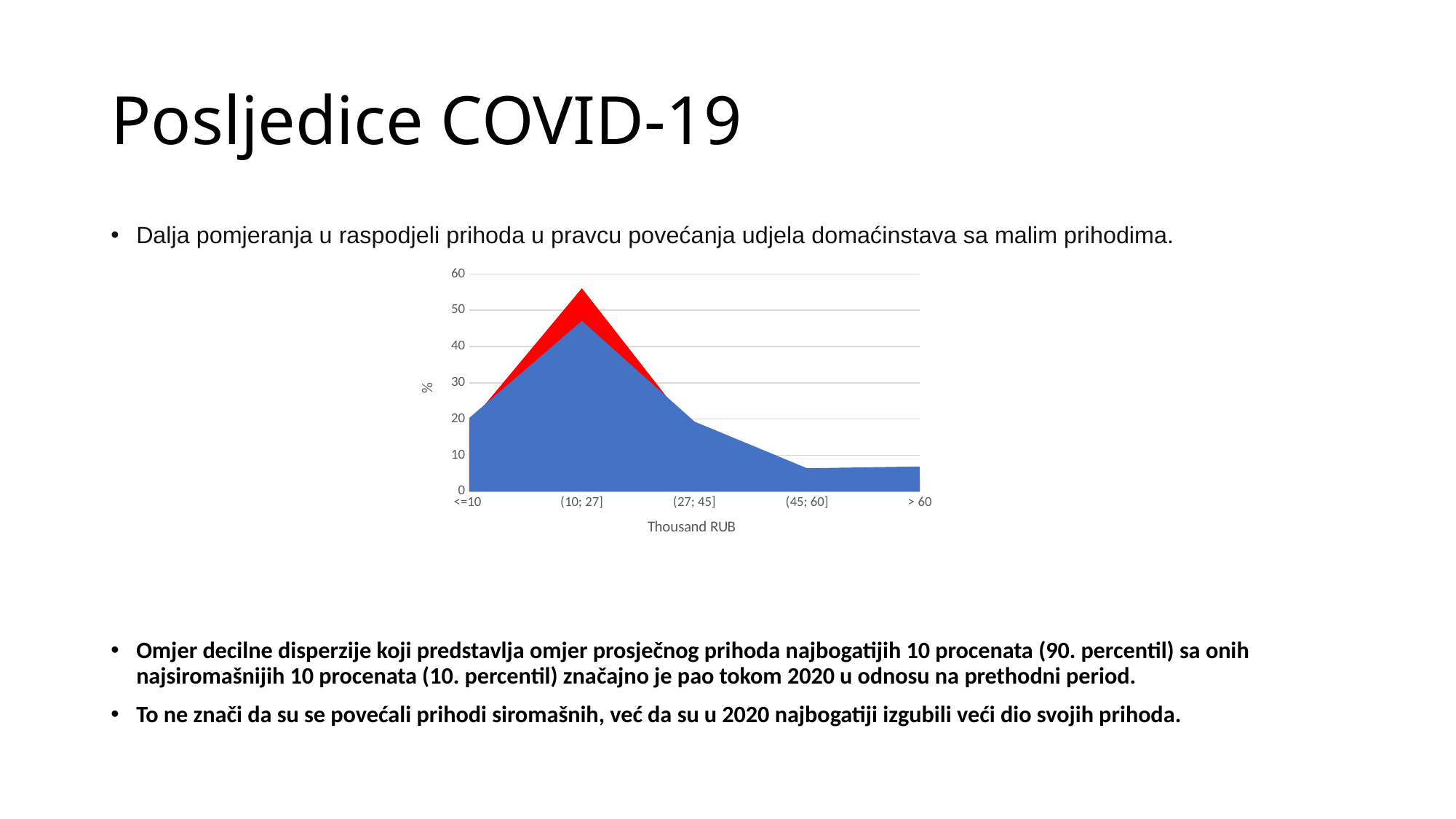
What kind of chart is shown on the slide? area chart Is the value for (45; 60] greater or less than 10? less Which income category has the highest value for the blue area? (10; 27] Do the values rise or fall along the x axis from (10; 27] to (45; 60]? fall Which is larger for the blue area: the value for (10; 27] or the value for (27; 45]? (10; 27] Which income category has the highest value for the red area? (10; 27] What is the label of the x axis of the chart? Thousand RUB Is the peak of the red area at (10; 27] greater or less than 50? greater Is the value of the blue area for (10; 27] greater or less than 40? greater What is the label of the y axis of the chart? % How many income categories are shown on the x axis of the chart? 5